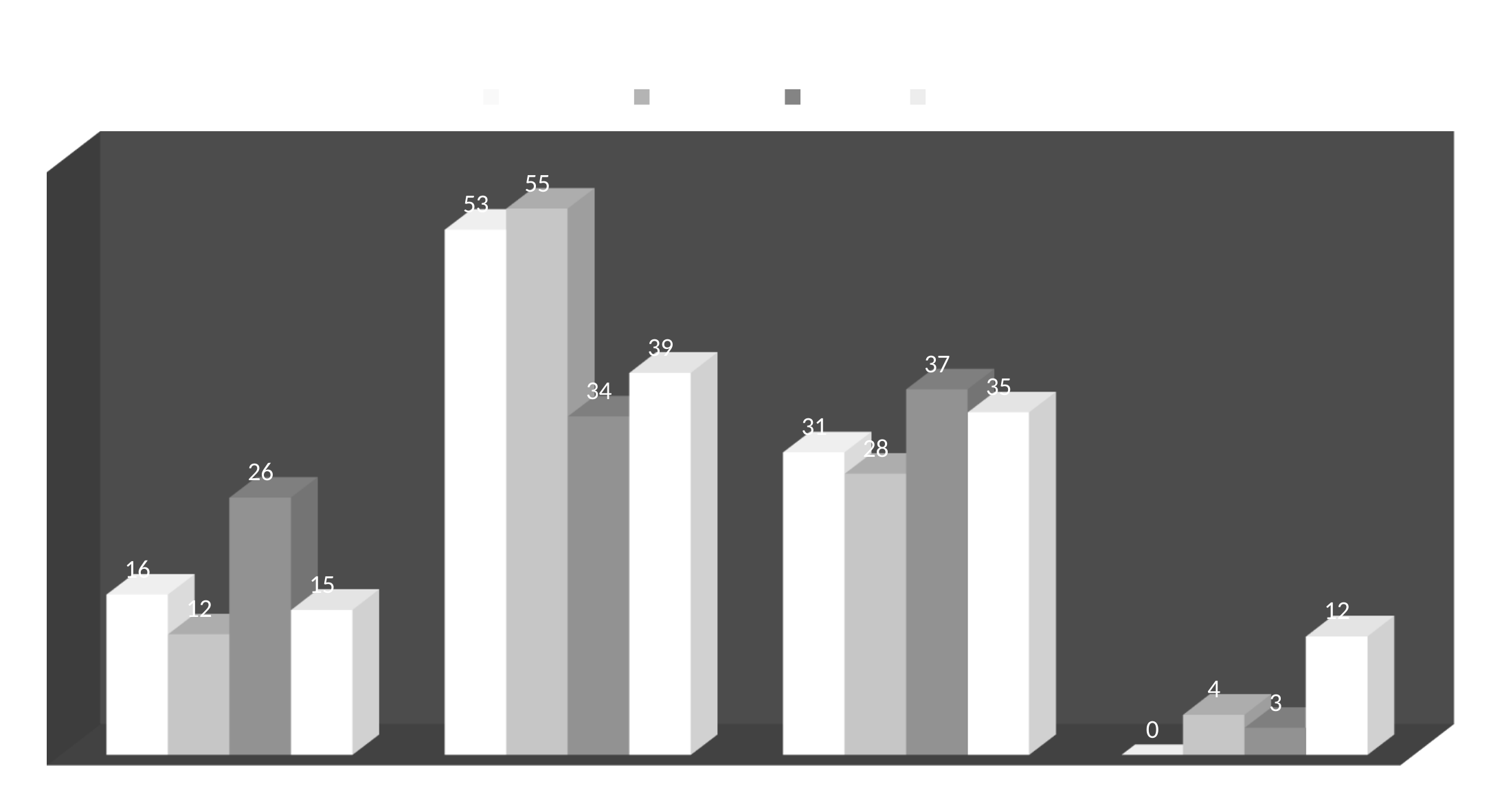
What is the value of the tallest bar in the second group from the left? 55 What kind of chart is shown on the slide? bar chart How many series does the legend list? 4 What is the difference between the fourth bar (12) and the second bar (4) in the fourth group from the left? 8 In the first group from the left, which is larger: the third bar (26) or the fourth bar (15)? the third bar (26) What is the lowest value labelled anywhere on the chart? 0 What is the highest value labelled anywhere on the chart? 55 How many groups of bars are plotted along the x axis? 4 What is the difference between the first bar (53) and the third bar (34) in the second group from the left? 19 What is the value of the third bar in the third group from the left? 37 What is the value of the first (leftmost) bar in the first group from the left? 16 What is the value of the first (leftmost) bar in the fourth group from the left? 0